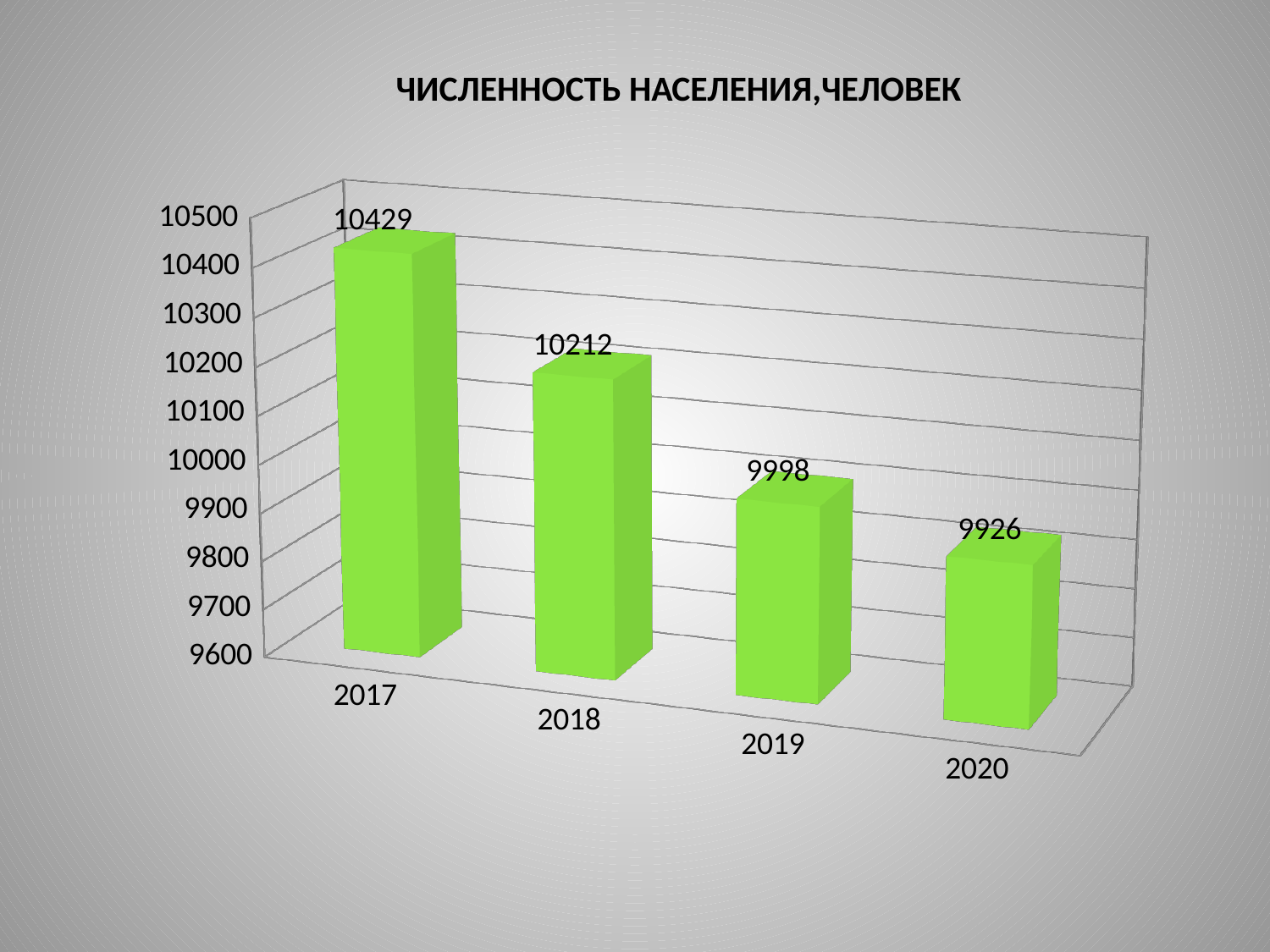
Which year has the lowest population value? 2020 What is the population value shown for 2019? 9998 What is the population value shown for 2017? 10429 Which is larger, the value for 2018 or the value for 2019? 2018 How many years are shown on the chart? 4 Is the value for 2019 greater or less than 10000? less What is the difference between the population values for 2017 and 2018? 217 What is the population value shown for 2020? 9926 What kind of chart is shown on the slide? bar chart Do the values rise or fall from 2017 to 2020? fall What is the difference between the population values for 2019 and 2020? 72 Which year has the highest population value? 2017